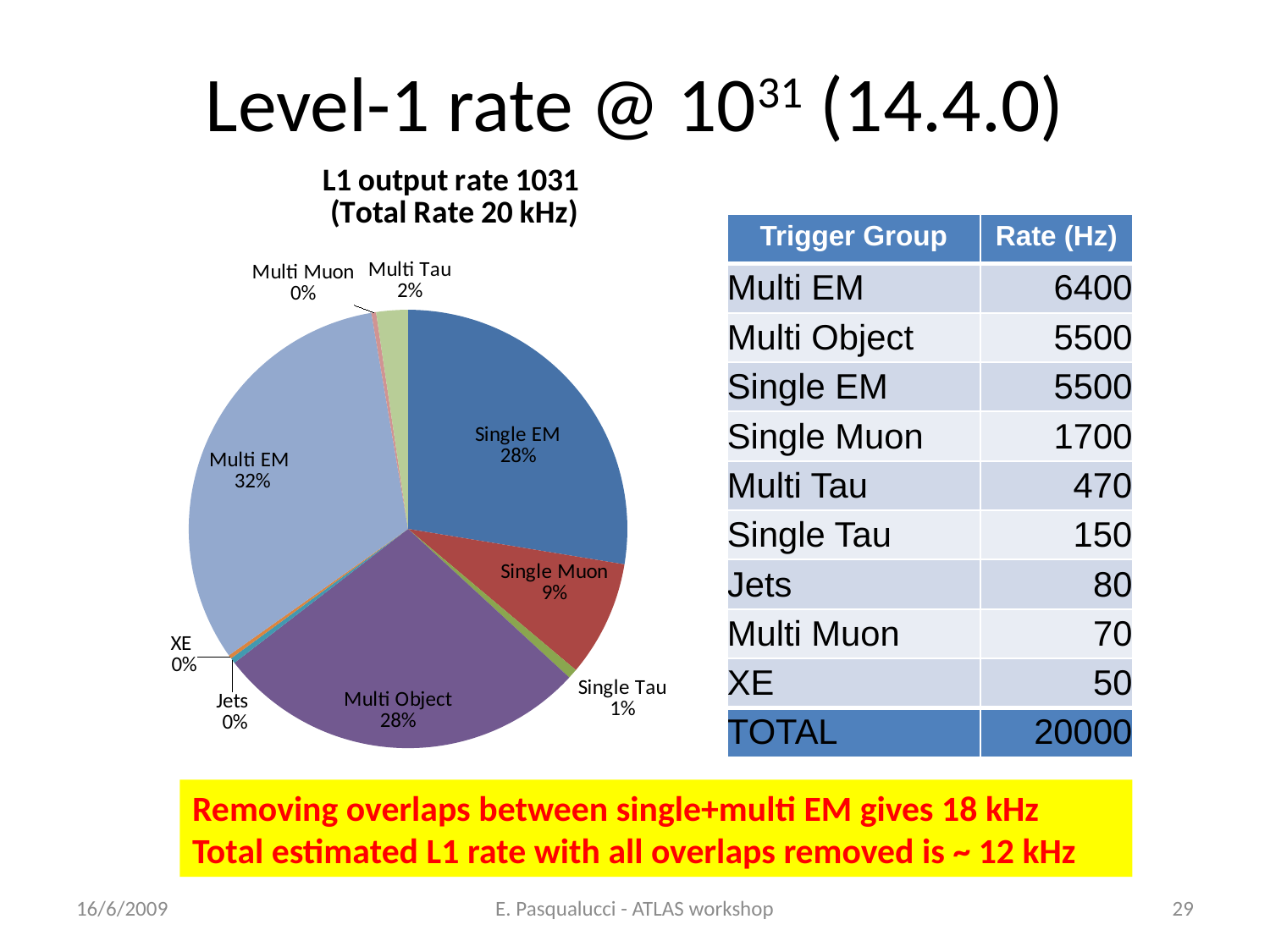
What is the title of the pie chart? L1 output rate 1031 (Total Rate 20 kHz) What share of the pie does Single Muon represent? 9% What percentage is shown for Multi Tau in the pie chart? 2% Which slice is larger in the pie chart, Multi EM or Single EM? Multi EM What type of chart is shown on the slide? pie chart How many slices does the pie chart have? 9 Which slice is larger in the pie chart, Single Muon or Multi Tau? Single Muon What share of the pie does Multi EM represent? 32% What is the difference in percentage points between the Multi EM and Single EM slices? 4% Which slice of the pie chart is the largest? Multi EM What percentage is shown for Single Tau in the pie chart? 1% What percentage is shown for Multi Object in the pie chart? 28%